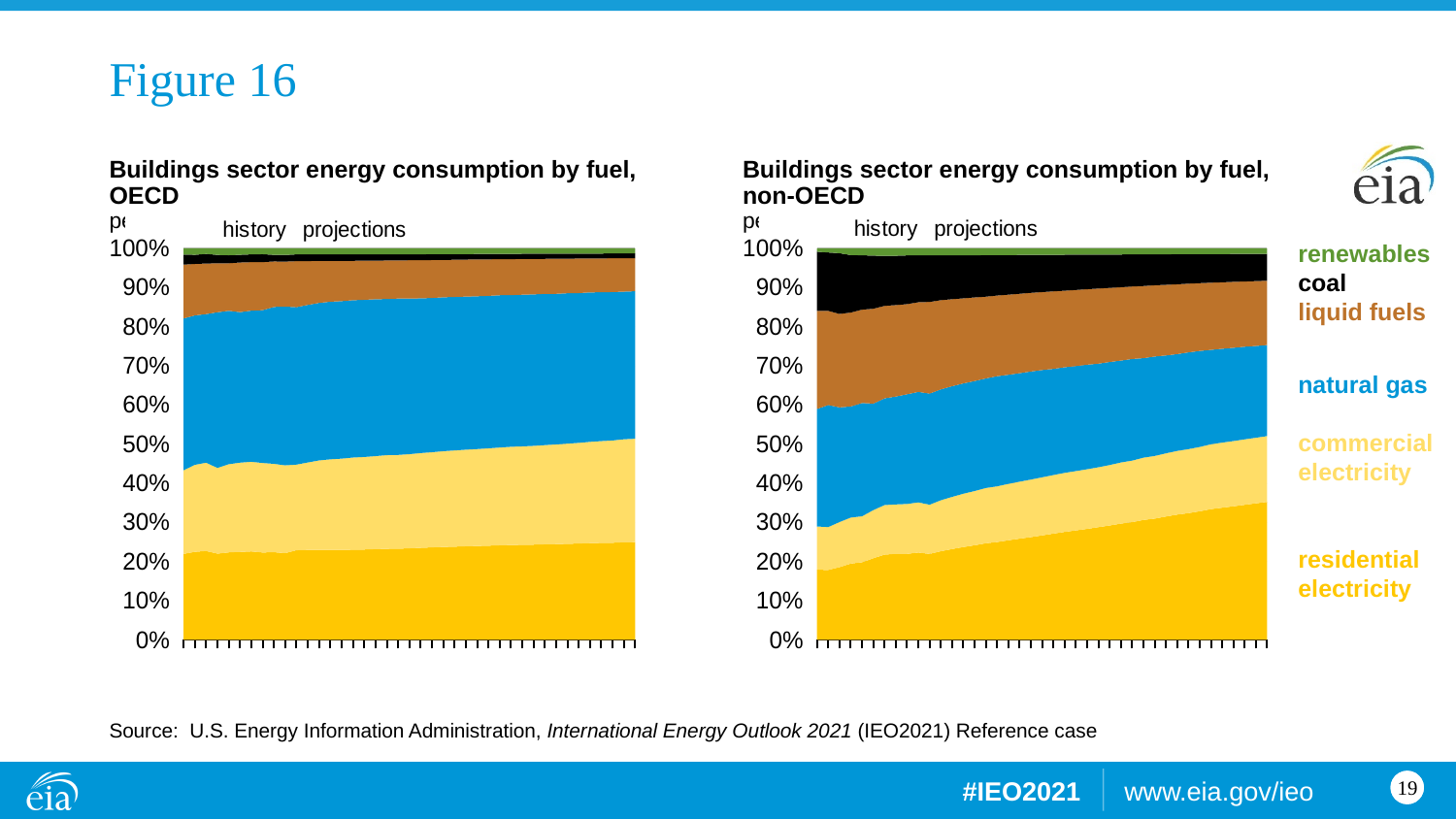
In the left chart (OECD), is the share of residential electricity at the end of the projection period greater or less than 30%? less In the left chart (OECD), which fuel has the largest share of buildings sector energy consumption? natural gas What is the title of the right chart? Buildings sector energy consumption by fuel, non-OECD In the left chart (OECD), which has the larger share: natural gas or coal? natural gas In the right chart (non-OECD), is the share of residential electricity at the end of the projection period greater or less than 30%? greater In the right chart (non-OECD), does the share of coal rise or fall over time? fall In the right chart (non-OECD), does the share of natural gas rise or fall over the projection period? fall What kind of chart is the left chart, 'Buildings sector energy consumption by fuel, OECD'? stacked area chart In the right chart (non-OECD), which fuel is shown in black? coal In the right chart (non-OECD), is the share of residential electricity at the start of the history period greater or less than 20%? less In the right chart (non-OECD), does the share of residential electricity rise or fall over the projection period? rise How many fuel categories does the legend on the right of the slide list? 6